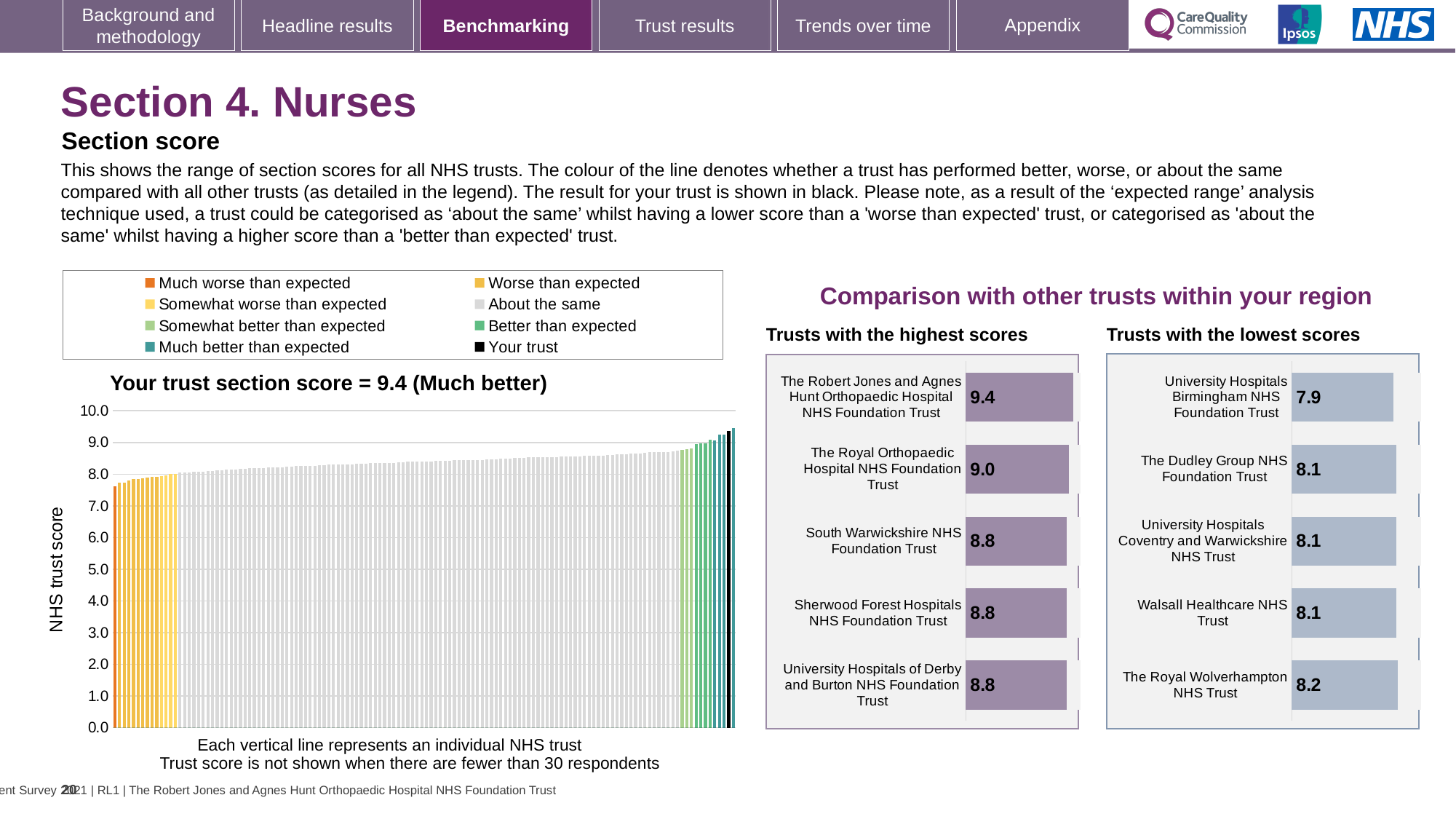
How many entries does the legend above the 'Your trust section score' chart list? 8 In the 'Your trust section score' chart, do the bars rise or fall from left to right? Rise In the 'Trusts with the lowest scores' chart, what is the score for University Hospitals Birmingham NHS Foundation Trust? 7.9 In the 'Your trust section score' chart, is the value of the leftmost bar greater or less than 8.0? less What type of chart is the 'Your trust section score' chart on the left? Bar chart In the 'Trusts with the lowest scores' chart, which trust has the lowest score? University Hospitals Birmingham NHS Foundation Trust In the 'Trusts with the lowest scores' chart, which has the larger score: The Royal Wolverhampton NHS Trust or University Hospitals Birmingham NHS Foundation Trust? The Royal Wolverhampton NHS Trust In the 'Trusts with the highest scores' chart, what is the difference between the scores of The Robert Jones and Agnes Hunt Orthopaedic Hospital NHS Foundation Trust and The Royal Orthopaedic Hospital NHS Foundation Trust? 0.4 In the 'Trusts with the highest scores' chart, which trust has the highest score? The Robert Jones and Agnes Hunt Orthopaedic Hospital NHS Foundation Trust In the 'Trusts with the highest scores' chart, what is the score for The Royal Orthopaedic Hospital NHS Foundation Trust? 9.0 In the 'Trusts with the lowest scores' chart, what is the difference between the scores of The Royal Wolverhampton NHS Trust and University Hospitals Birmingham NHS Foundation Trust? 0.3 How many trusts are listed in the 'Trusts with the highest scores' chart? 5